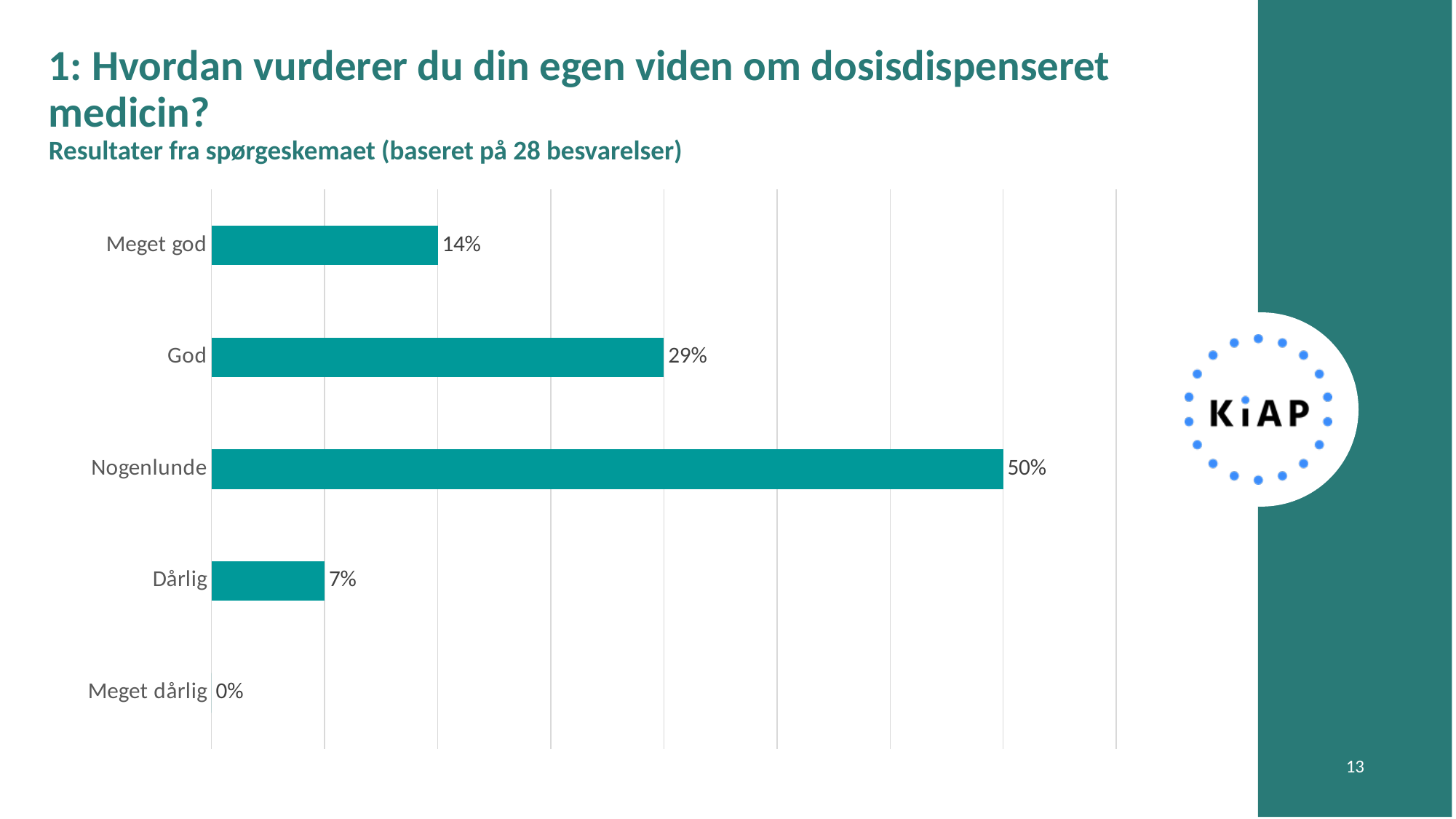
What is the difference between the values for Meget god and Dårlig? 7% What is the value for Nogenlunde? 50% How many categories are shown in the chart? 5 What is the difference between the values for Nogenlunde and God? 21% Which is larger, the value for God or the value for Meget god? God What is the value for Dårlig? 7% What is the value for God? 29% Which category has the lowest value? Meget dårlig Which category has the highest value? Nogenlunde What is the value for Meget dårlig? 0% What is the value for Meget god? 14% What kind of chart is shown on the slide? Bar chart